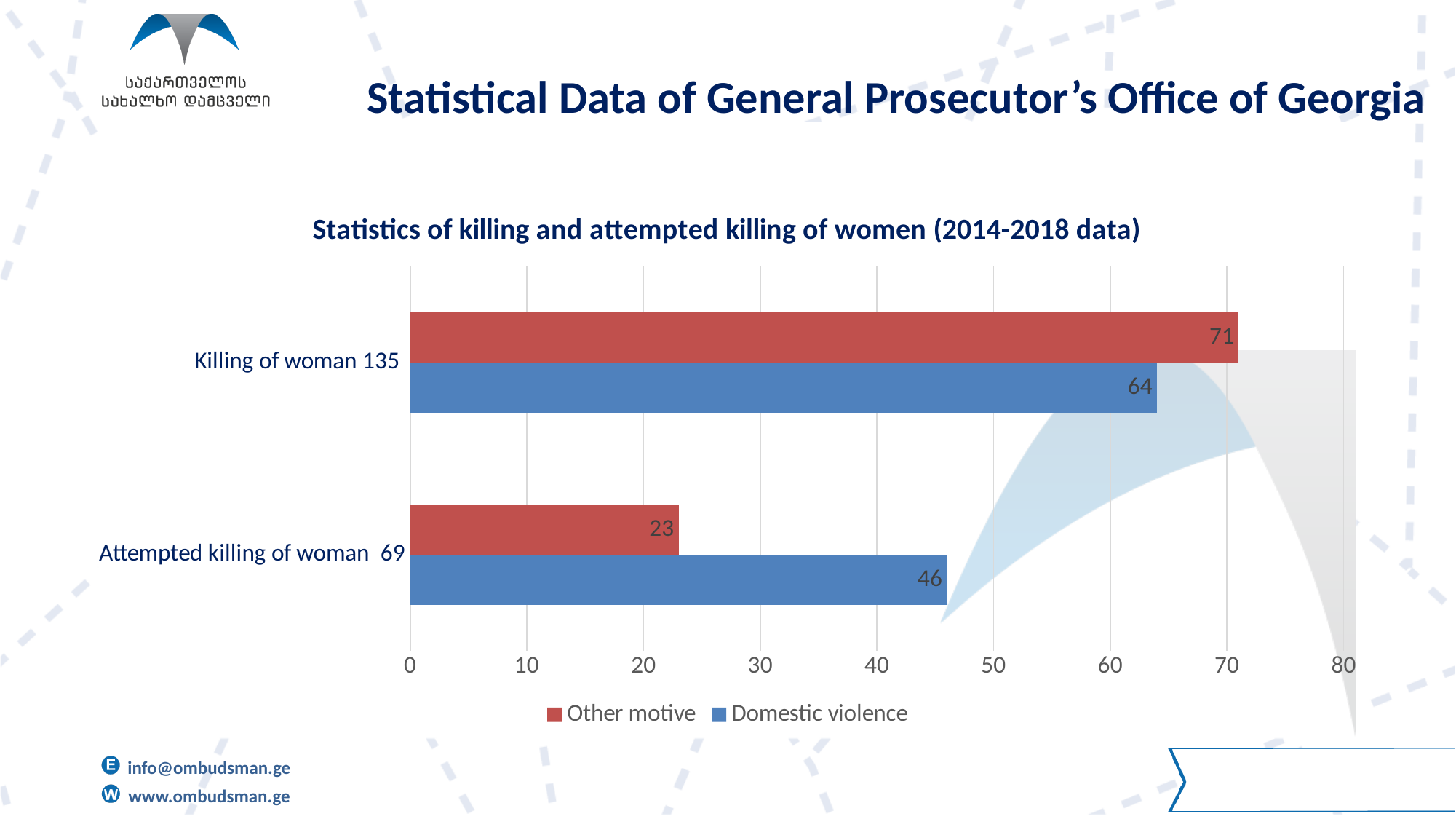
What is the value for Domestic violence in the Killing of woman 135 category? 64 What is the value for Other motive in the Killing of woman 135 category? 71 What kind of chart is shown on the slide? Bar chart Which category has the highest Domestic violence value? Killing of woman 135 What is the difference between the Other motive and Domestic violence values for Killing of woman 135? 7 What is the difference between the Domestic violence and Other motive values for Attempted killing of woman 69? 23 Which category has the lowest Other motive value? Attempted killing of woman 69 What is the value for Other motive in the Attempted killing of woman 69 category? 23 For Attempted killing of woman 69, which is larger: Other motive or Domestic violence? Domestic violence What is the value for Domestic violence in the Attempted killing of woman 69 category? 46 How many series does the legend list? 2 How many categories are shown on the chart? 2